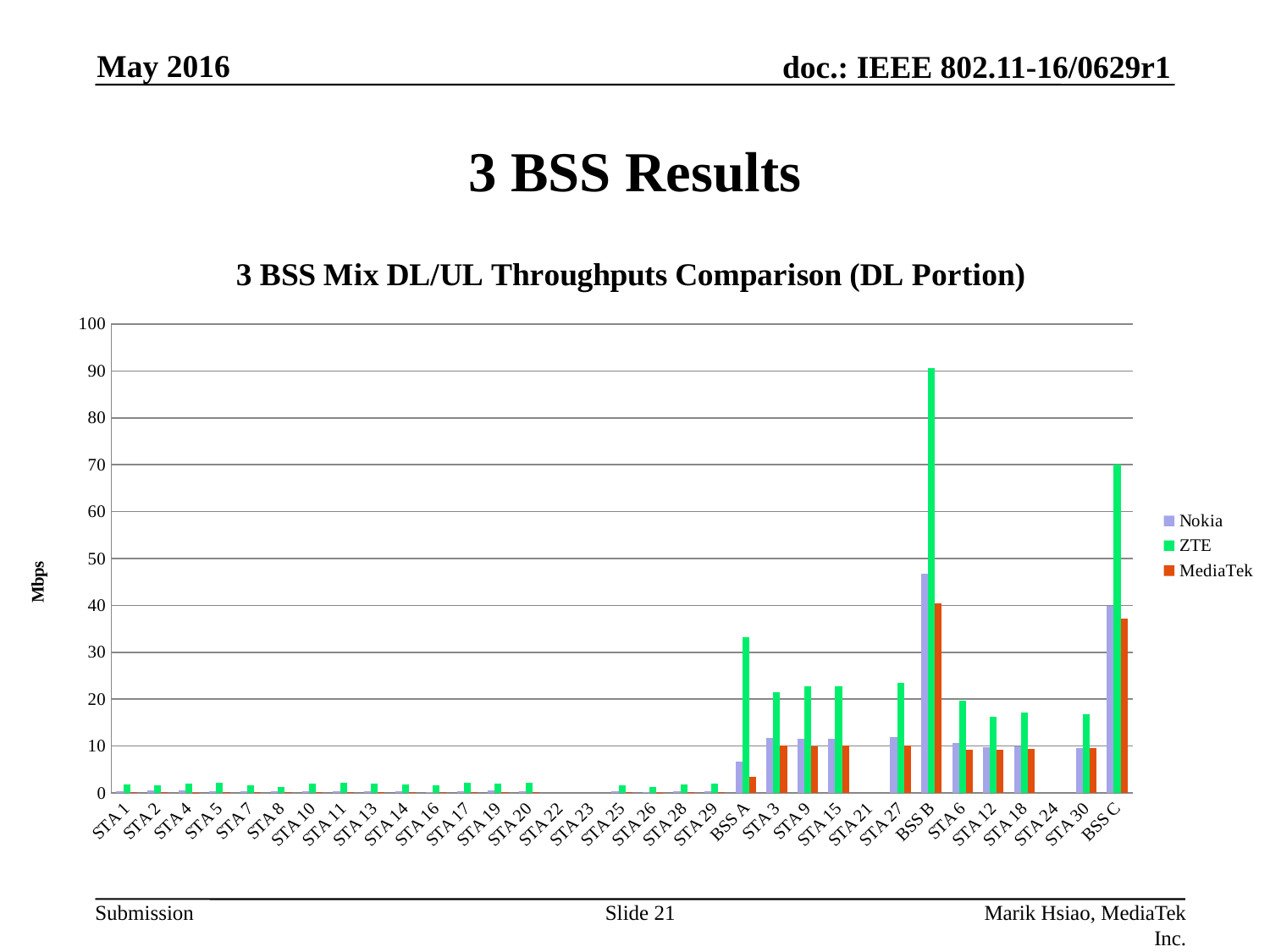
For BSS A, which is larger, the ZTE value or the Nokia value? ZTE Is the ZTE value for BSS C greater or less than 60? greater How many categories are shown along the x axis? 33 Is the Nokia value for BSS B greater or less than 40? greater Is the ZTE value for BSS B greater or less than 80? greater Which series does the legend list between Nokia and MediaTek? ZTE How many series does the legend list? 3 What kind of chart is shown on the slide? bar chart For which category is the Nokia value highest? BSS B For which category is the ZTE value highest? BSS B What is the label on the vertical axis? Mbps